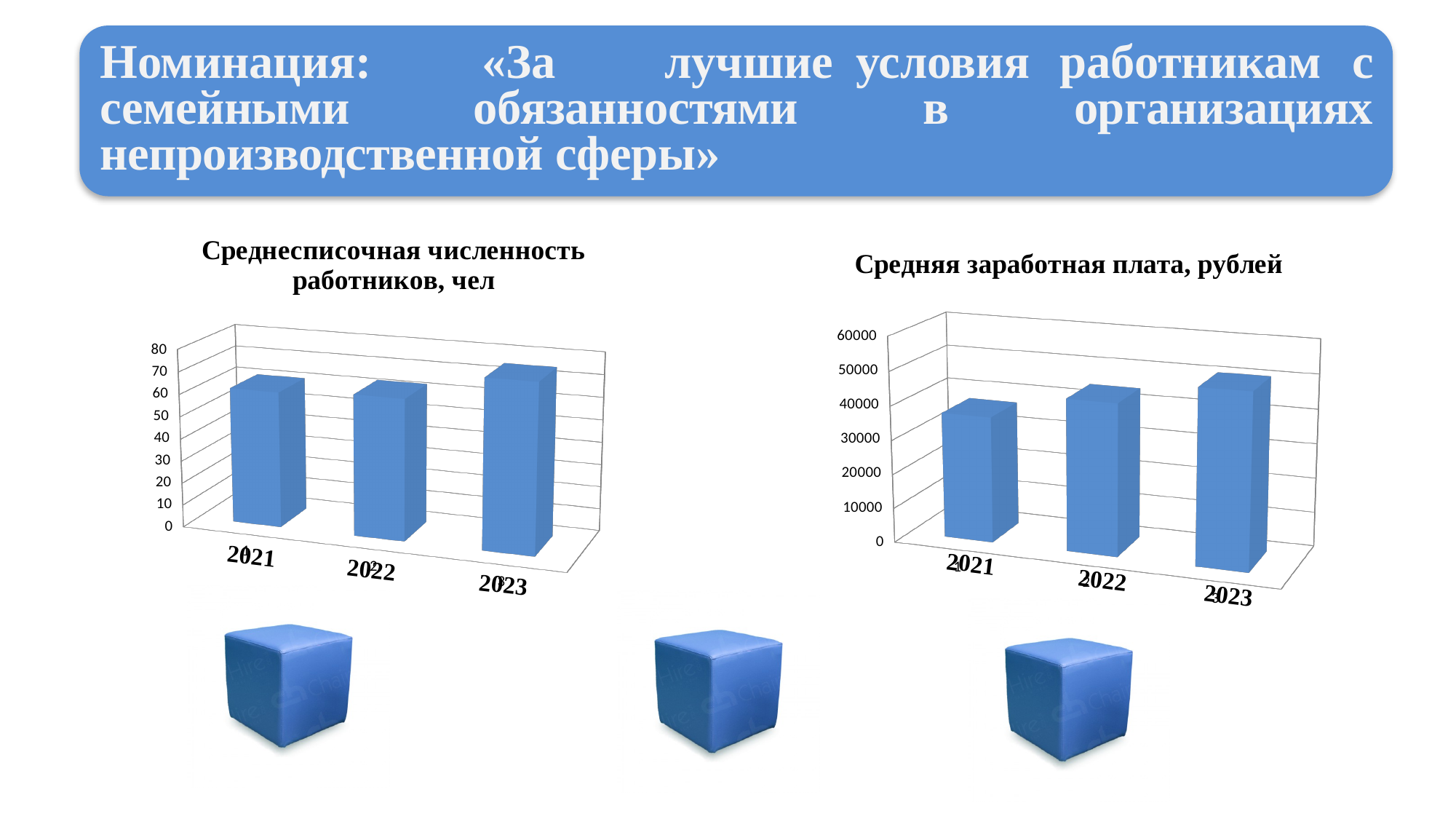
In the chart titled "Средняя заработная плата, рублей", how many years are shown on the x axis? 3 In the chart titled "Средняя заработная плата, рублей", is the value for 2021 greater or less than 20000? greater In the chart titled "Среднесписочная численность работников, чел", how many years are shown on the x axis? 3 In the chart titled "Средняя заработная плата, рублей", which is larger, the value for 2021 or the value for 2023? 2023 In the chart titled "Среднесписочная численность работников, чел", which year has the highest value? 2023 What kind of chart is the chart titled "Среднесписочная численность работников, чел"? bar chart In the chart titled "Средняя заработная плата, рублей", is the value for 2023 greater or less than 30000? greater In the chart titled "Средняя заработная плата, рублей", which year has the lowest value? 2021 In the chart titled "Средняя заработная плата, рублей", which year has the highest value? 2023 In the chart titled "Средняя заработная плата, рублей", do the values rise or fall from 2021 to 2023? rise In the chart titled "Среднесписочная численность работников, чел", is the value for 2023 greater or less than 40? greater What kind of chart is the chart titled "Средняя заработная плата, рублей"? bar chart